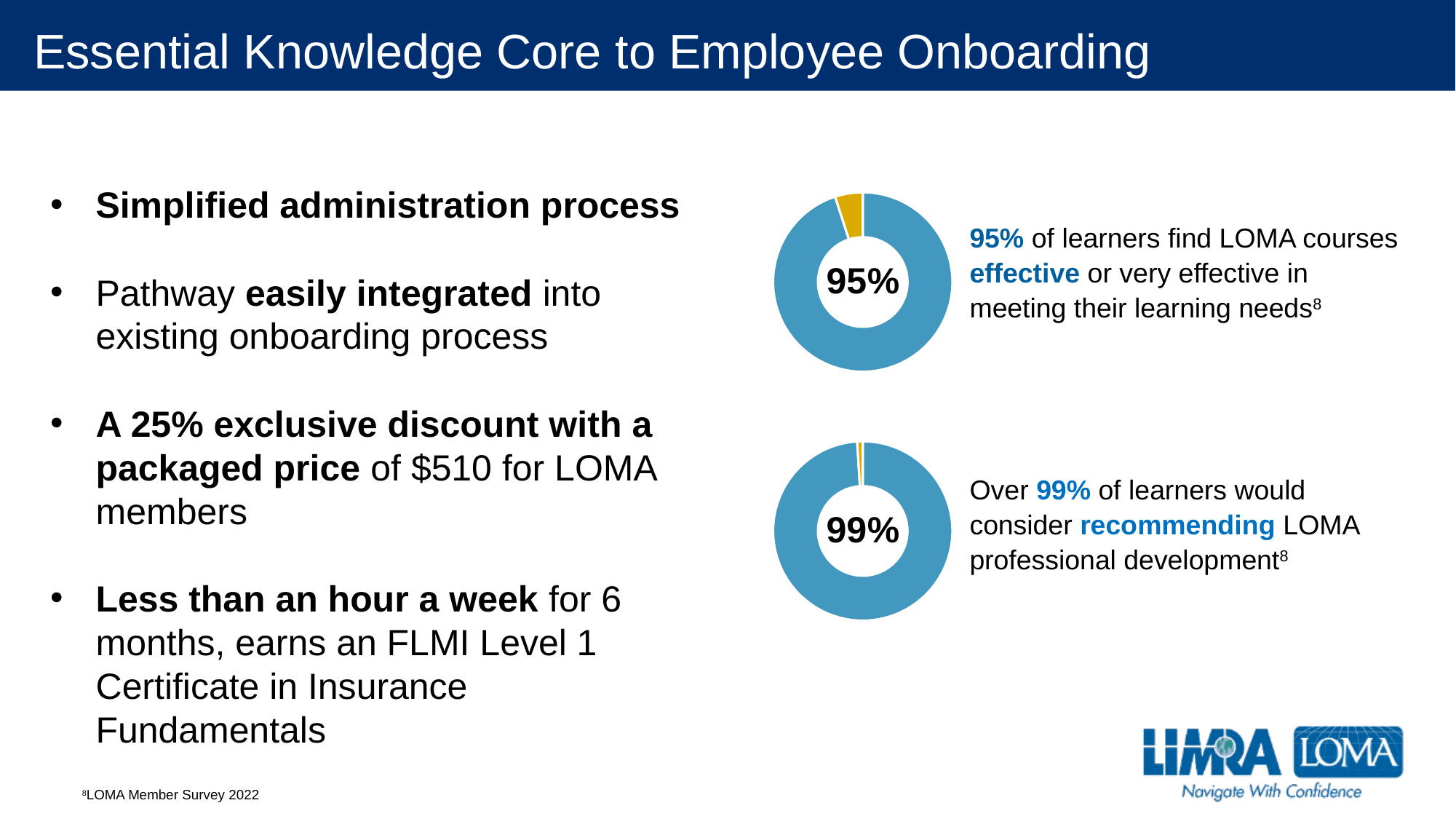
What percentage is printed in the centre of the upper donut chart? 95% What percentage is printed in the centre of the lower donut chart? 99% Which donut chart shows the larger highlighted share, the upper chart (effective courses) or the lower chart (would recommend)? The lower chart (99%) How many slices does the upper donut chart have? 2 What is the difference between the percentage shown in the lower donut chart and the percentage shown in the upper donut chart? 4% What kind of chart is the lower chart on the right side of the slide? Donut chart In the lower donut chart, what share of learners would consider recommending LOMA professional development? 99% What colour is the small slice in the upper donut chart? Gold/yellow How many slices does the lower donut chart have? 2 What colour is the large slice in both donut charts? Blue What kind of chart is the upper chart on the right side of the slide? Donut chart In the upper donut chart, what share of learners find LOMA courses effective or very effective? 95%